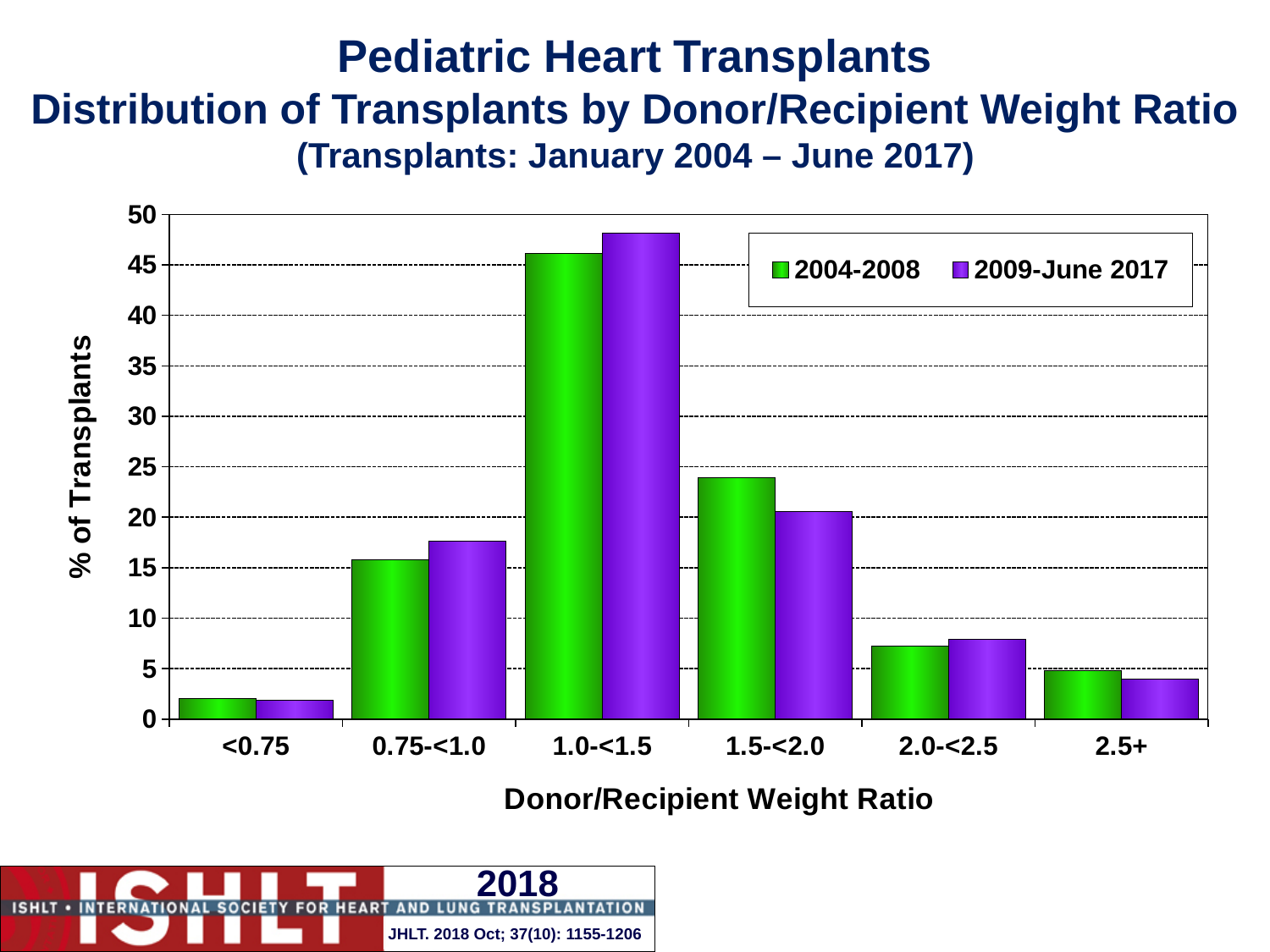
Is the value for 2004-2008 in the 1.5-<2.0 category greater or less than 20? greater Which weight ratio category has the highest value for the 2009-June 2017 series? 1.0-<1.5 Is the value for 2009-June 2017 in the 1.0-<1.5 category greater or less than 45? greater How many donor/recipient weight ratio categories are shown on the x axis? 6 In the 1.5-<2.0 category, which series has the larger value, 2004-2008 or 2009-June 2017? 2004-2008 What is the title of the y axis? % of Transplants Which weight ratio category has the highest value for the 2004-2008 series? 1.0-<1.5 How many series does the legend list? 2 Is the value for 2009-June 2017 in the 2.5+ category greater or less than 5? less What kind of chart is shown on the slide? bar chart Which weight ratio category has the lowest value for the 2004-2008 series? <0.75